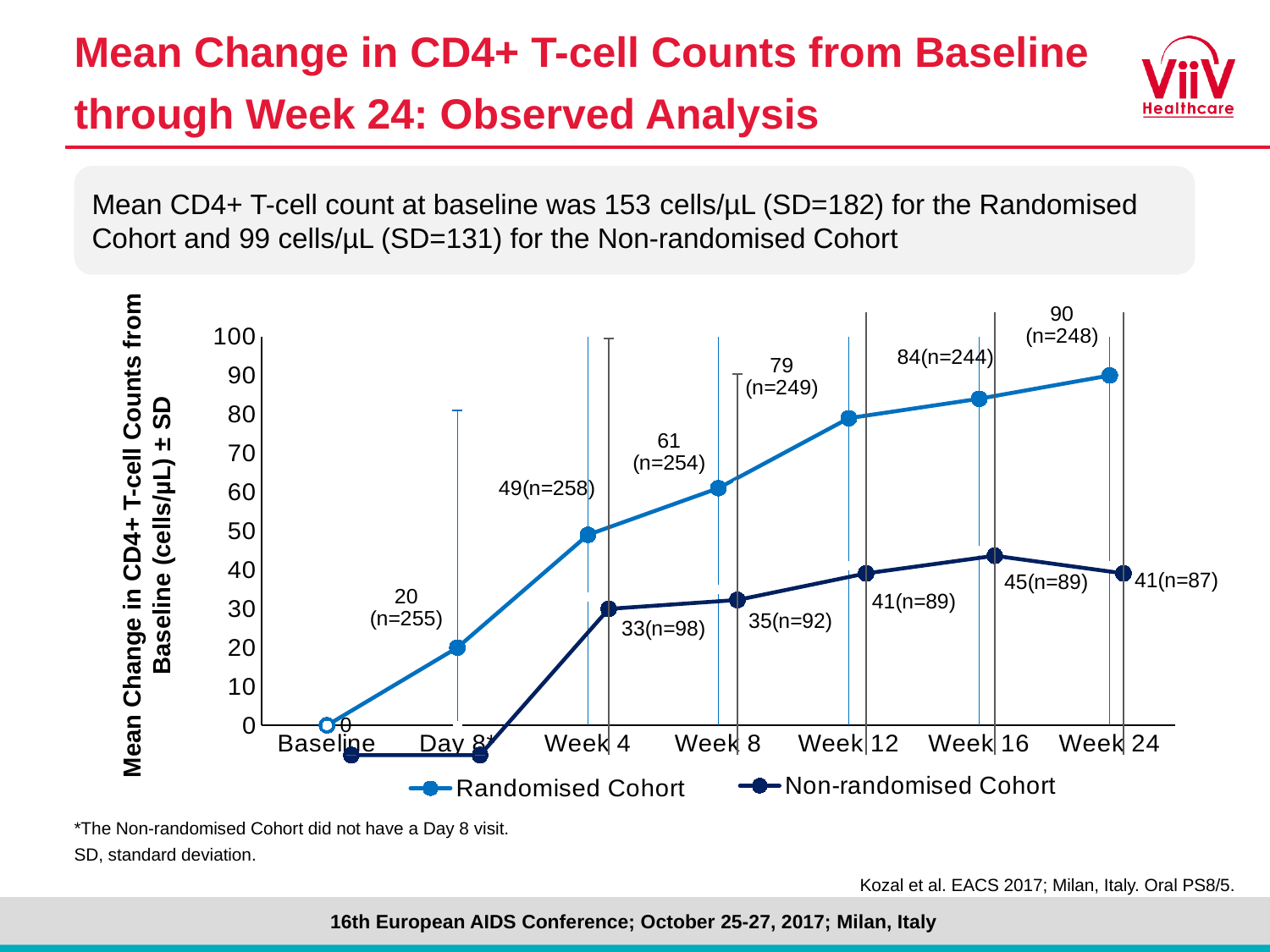
What is the n value shown for the Randomised Cohort at Week 8? 254 How many series does the legend list? 2 What is the mean change for the Randomised Cohort at Day 8? 20 What type of chart is shown on the slide? line chart How many time points are labelled on the x axis? 7 What is the mean change in CD4+ T-cell count for the Randomised Cohort at Week 24? 90 At which time point does the Randomised Cohort reach its highest mean change? Week 24 Which cohort has the larger mean change at Week 4? Randomised Cohort At which time point is the Non-randomised Cohort's mean change lowest among the labelled values? Week 4 Does the Randomised Cohort's mean change rise or fall from Baseline to Week 24? rise What is the difference between the Randomised and Non-randomised Cohort mean changes at Week 12? 38 What is the mean change in CD4+ T-cell count for the Non-randomised Cohort at Week 16? 45